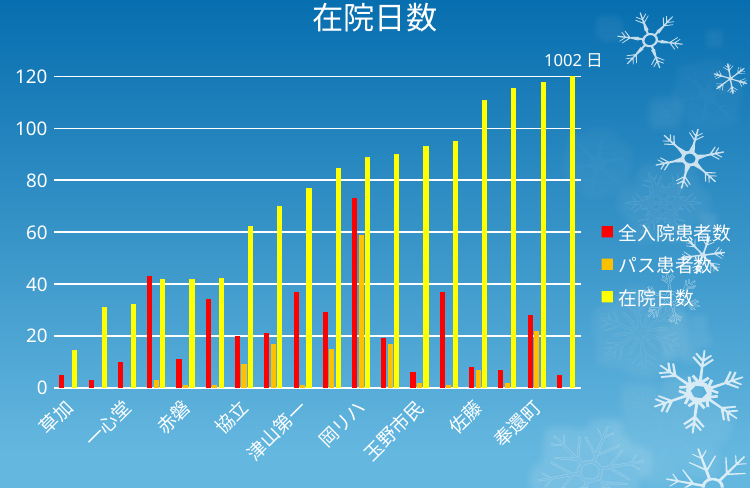
Which has the larger 全入院患者数 value, 岡リハ or 奉還町? 岡リハ Do the 在院日数 values rise or fall moving left to right along the x axis? rise Is the 在院日数 value for 岡リハ greater or less than 80? greater How many series does the legend list? 3 What data label is printed above the tallest 在院日数 bar? 1002 日 Is the 在院日数 value for 佐藤 greater or less than 100? greater What kind of chart is shown on the slide? bar chart Among the labeled categories, which has the lowest 在院日数 value? 草加 Is the 在院日数 value for 草加 greater or less than 20? less What is the title of the chart? 在院日数